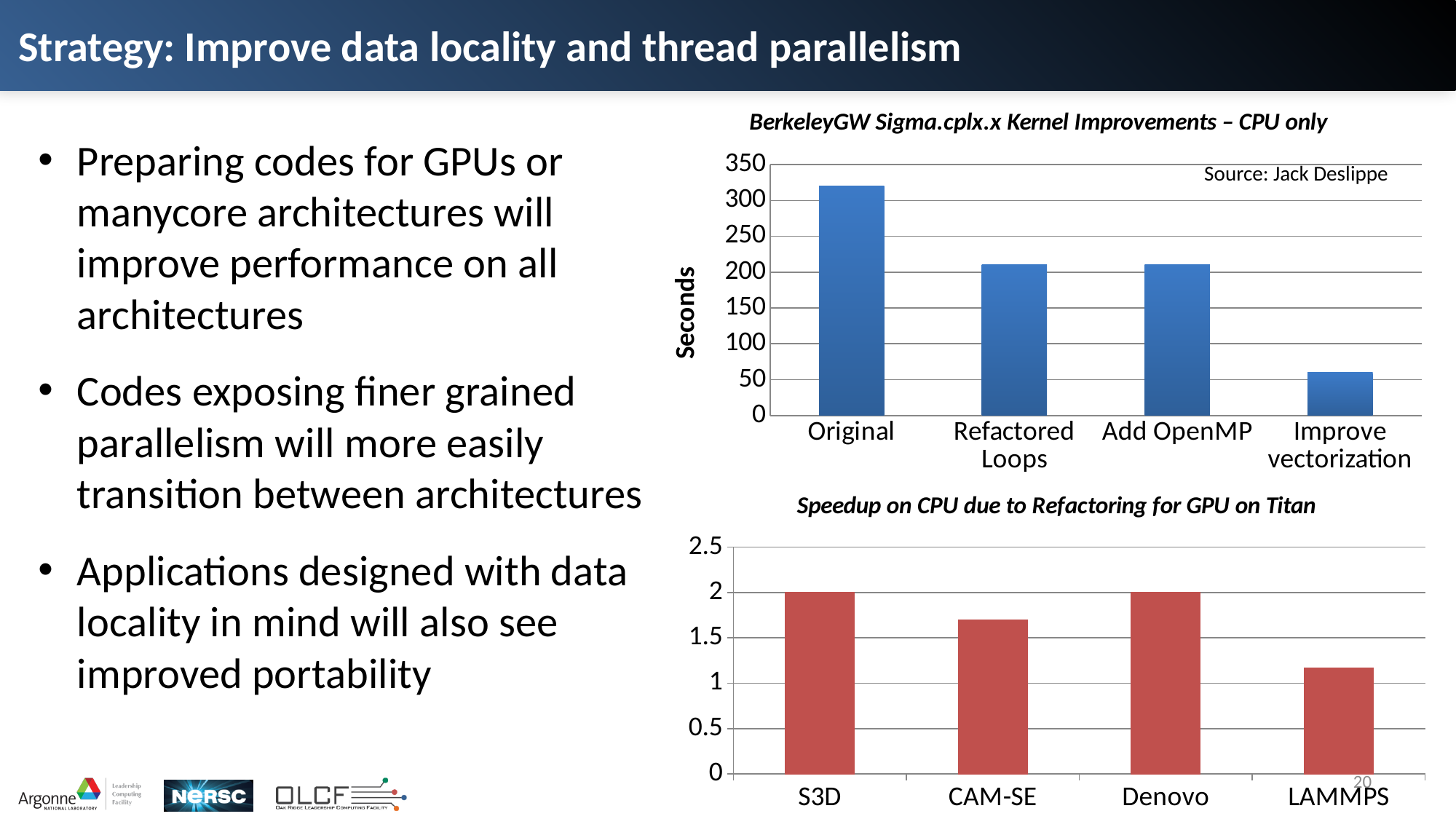
In the top chart (BerkeleyGW Sigma.cplx.x Kernel Improvements), is the value for Improve vectorization greater or less than 100? less In the top chart (BerkeleyGW Sigma.cplx.x Kernel Improvements), which category has the highest value? Original In the top chart (BerkeleyGW Sigma.cplx.x Kernel Improvements), which category has the lowest value? Improve vectorization How many categories are shown on the x axis of the top chart (BerkeleyGW Sigma.cplx.x Kernel Improvements)? 4 In the bottom chart (Speedup on CPU due to Refactoring for GPU on Titan), what is the speedup for S3D? 2 In the bottom chart (Speedup on CPU due to Refactoring for GPU on Titan), which application has the lowest speedup? LAMMPS In the top chart (BerkeleyGW Sigma.cplx.x Kernel Improvements), is the value for Original greater or less than 300? greater What is the y-axis label of the top chart (BerkeleyGW Sigma.cplx.x Kernel Improvements)? Seconds In the bottom chart (Speedup on CPU due to Refactoring for GPU on Titan), which is larger, the value for Denovo or the value for LAMMPS? Denovo What kind of chart is the top chart titled 'BerkeleyGW Sigma.cplx.x Kernel Improvements – CPU only'? bar chart In the bottom chart (Speedup on CPU due to Refactoring for GPU on Titan), is the value for CAM-SE greater or less than 1.5? greater